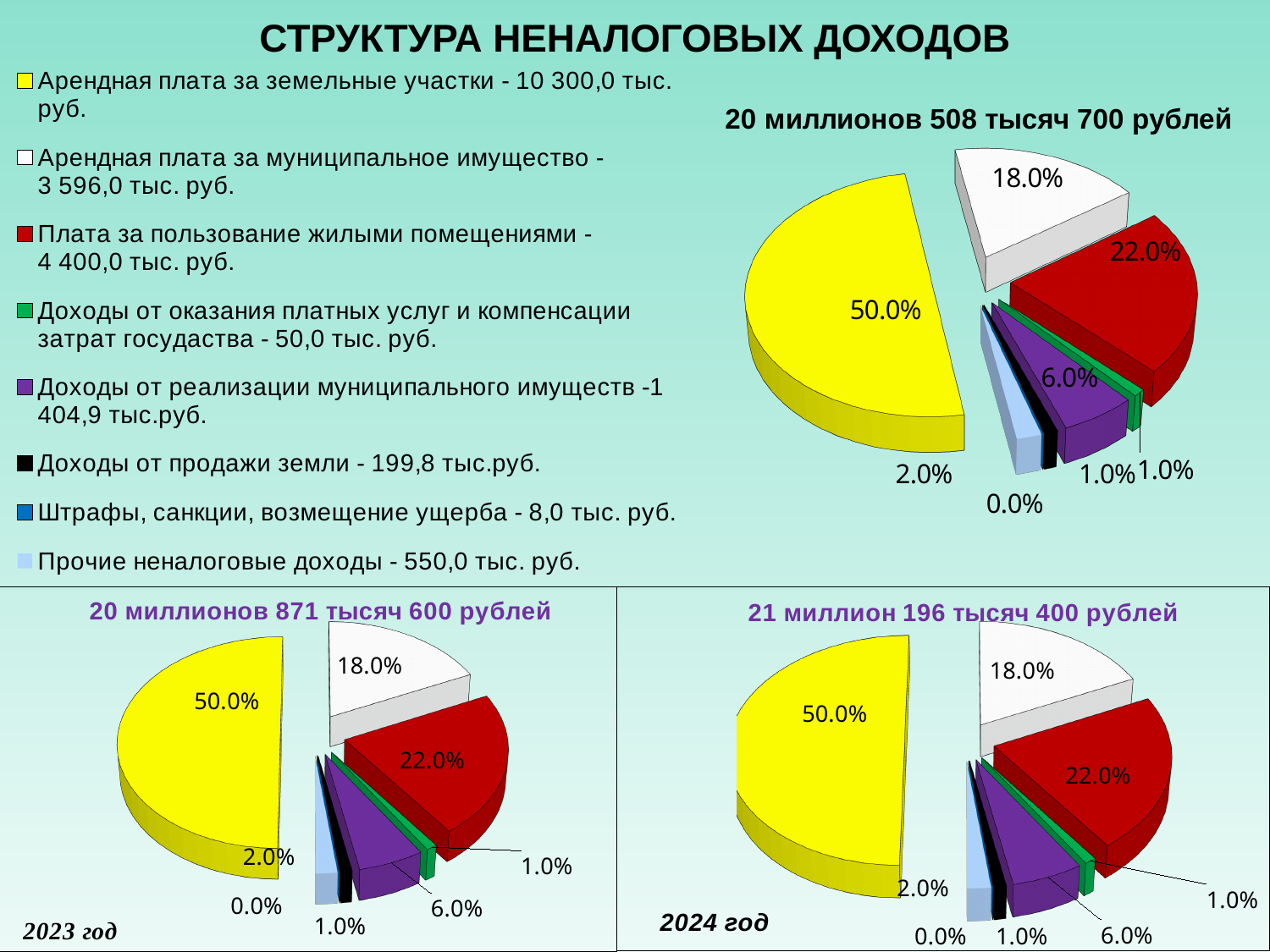
What kind of chart is shown at the top right of the slide? pie chart In the top-right pie chart, what share is shown for the white slice (Арендная плата за муниципальное имущество)? 18.0% In the bottom-left pie chart (2023 год), which is larger: the red slice or the white slice? the red slice What is the title of the bottom-right pie chart? 21 миллион 196 тысяч 400 рублей In the top-right pie chart (20 миллионов 508 тысяч 700 рублей), what share is shown for the yellow slice (Арендная плата за земельные участки)? 50.0% In the top-right pie chart, what share is shown for the purple slice (Доходы от реализации муниципального имущества)? 6.0% In the top-right pie chart, which category has the largest slice? Арендная плата за земельные участки Which year is labelled under the bottom-left pie chart? 2023 год How many categories does the legend on the left list? 8 How many charts are on the slide? 3 In the bottom-right pie chart (2024 год), what is the difference between the red slice (22.0%) and the white slice (18.0%)? 4.0%